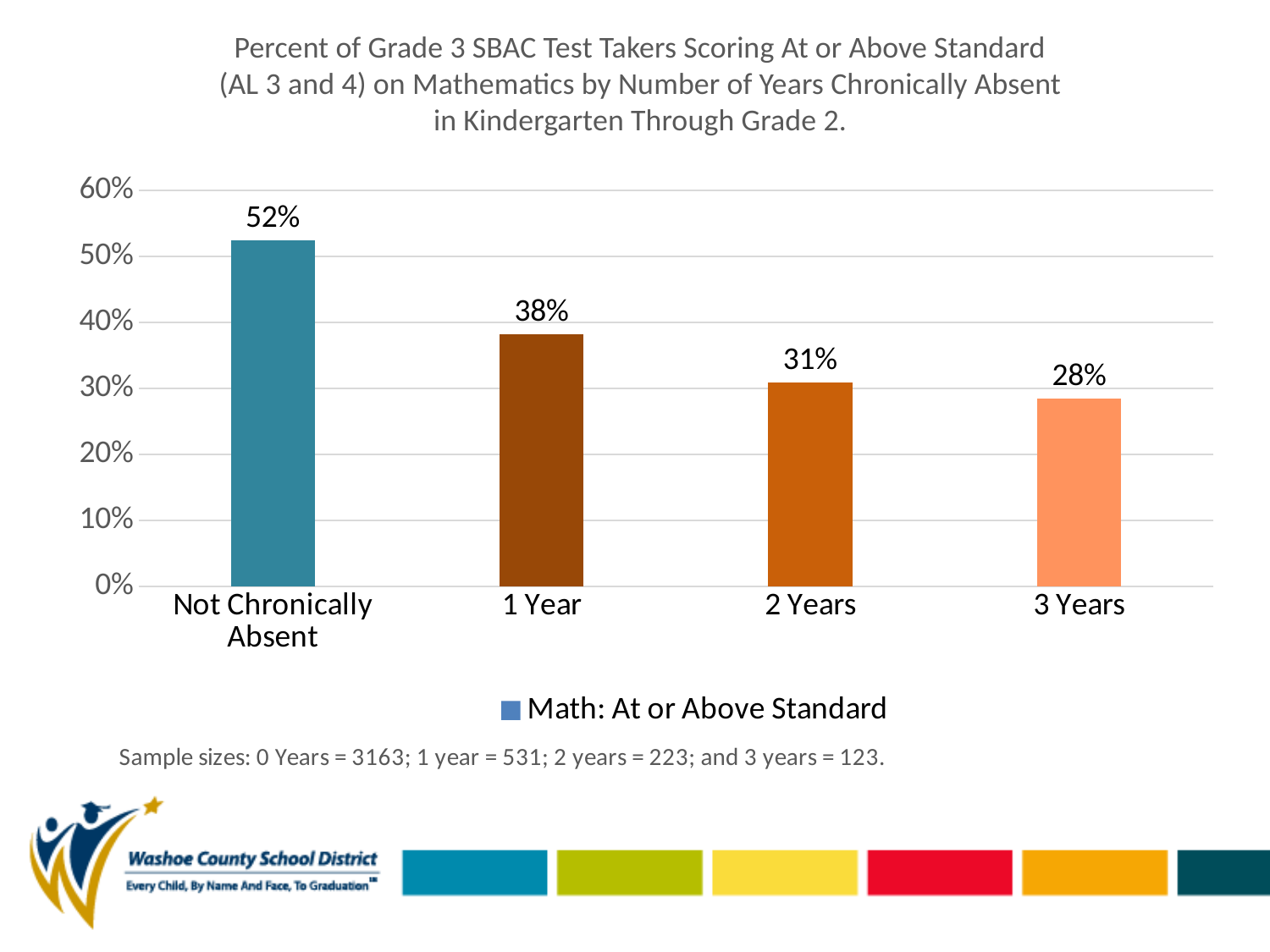
Which category has the lowest percent scoring at or above standard? 3 Years Do the values rise or fall as the number of years chronically absent increases along the x axis? Fall What is the value for students chronically absent for 3 years? 28% What is the value for students chronically absent for 1 year? 38% How many categories are shown on the x axis? 4 Is the value for 1 Year greater or less than 40%? less Which is larger, the value for 2 Years or the value for 3 Years? 2 Years What is the difference between the values for 1 Year and 2 Years? 7 percentage points Which category has the highest percent scoring at or above standard? Not Chronically Absent What is the difference in percentage points between the Not Chronically Absent group and the 3 Years group? 24 percentage points What kind of chart is shown on the slide? Bar chart What percent of Grade 3 SBAC test takers who were not chronically absent scored at or above standard in mathematics? 52%